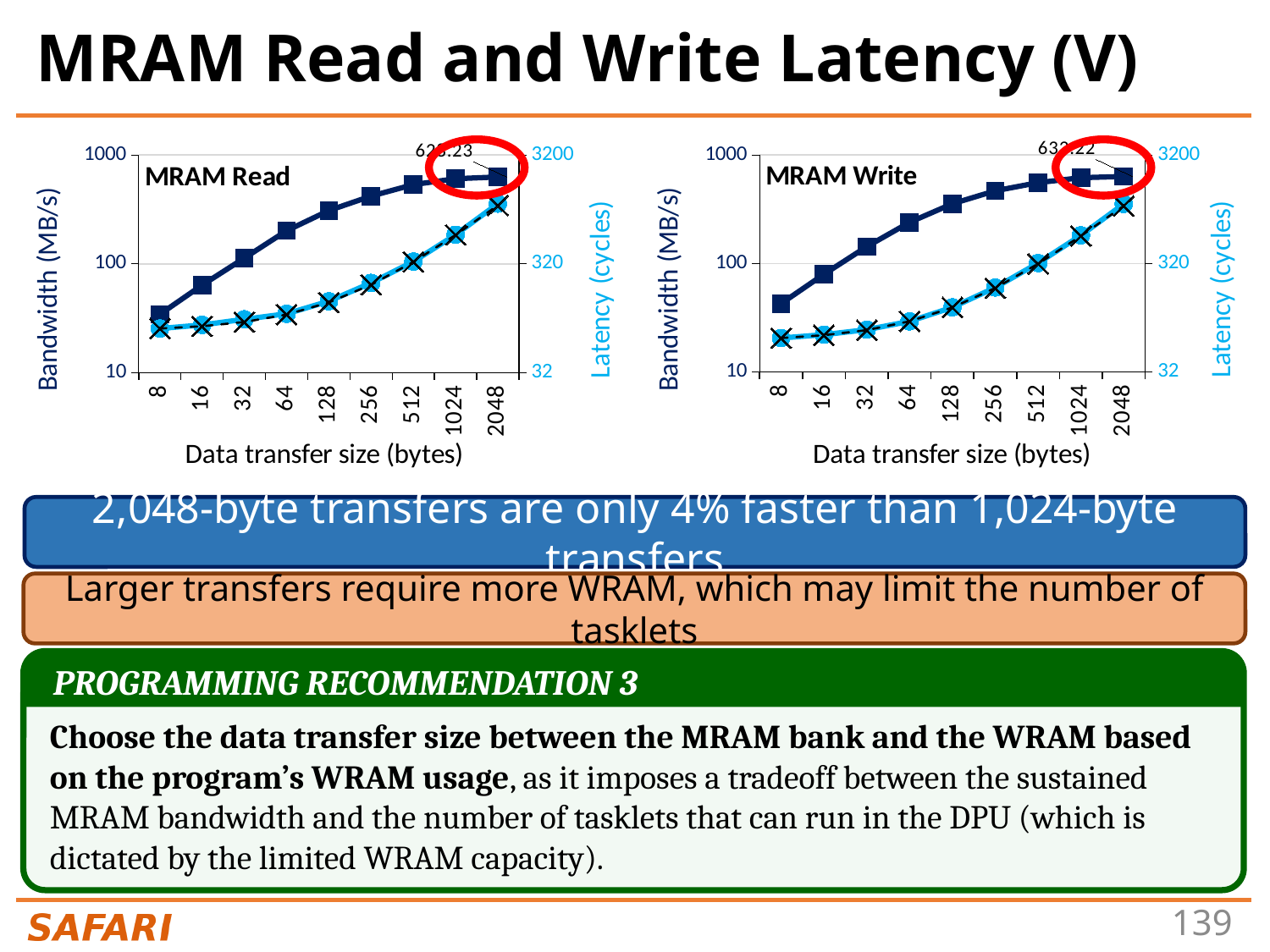
In the MRAM Write chart, does latency rise or fall as the data transfer size increases? rise What is the x-axis label of the MRAM Write chart? Data transfer size (bytes) In the MRAM Read chart, is the bandwidth for 64 bytes greater or less than 100 MB/s? greater In the MRAM Read chart, does bandwidth rise or fall as the data transfer size increases? rise In the MRAM Write chart, which has the higher bandwidth: 8 bytes or 2048 bytes? 2048 bytes In the MRAM Read chart, which data transfer size has the lowest bandwidth? 8 How many data transfer sizes are plotted on the x axis of the MRAM Write chart? 9 In the MRAM Write chart, is the latency for 8 bytes greater or less than 320 cycles? less In the MRAM Read chart, is the bandwidth for 8 bytes greater or less than 100 MB/s? less What kind of chart is the MRAM Read chart? line chart